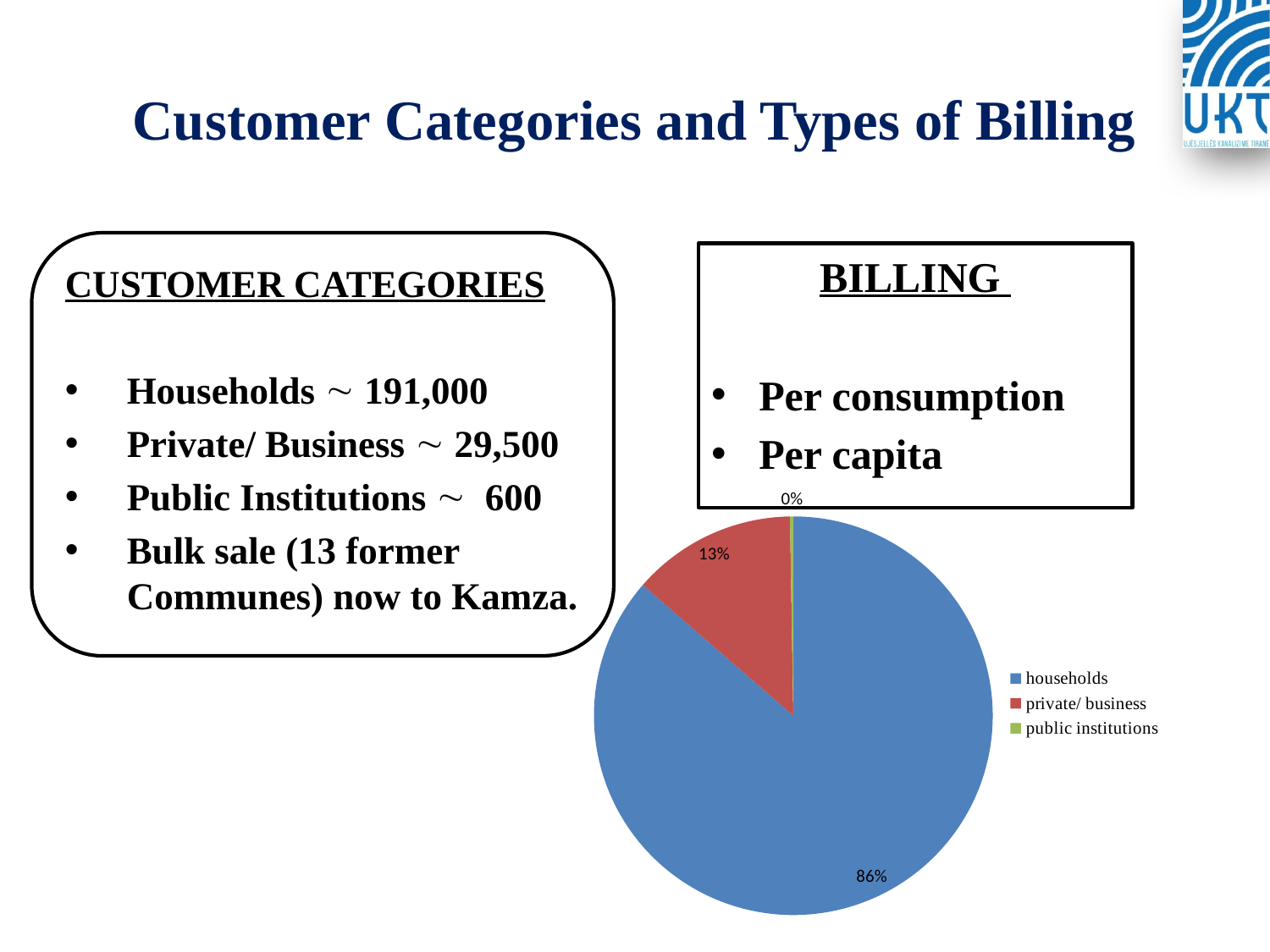
What colour is the private/ business slice? red Which category has the largest slice of the pie? households What share of the pie does households represent? 86% Which category has the smallest slice of the pie? public institutions What kind of chart is shown on the slide? pie chart Which slice is larger, households or private/ business? households What is the difference in percentage points between the households slice and the private/ business slice? 73 What share of the pie does private/ business represent? 13% What colour is the households slice? blue How many entries does the legend list? 3 What share of the pie does public institutions represent? 0% How many categories does the pie chart show? 3